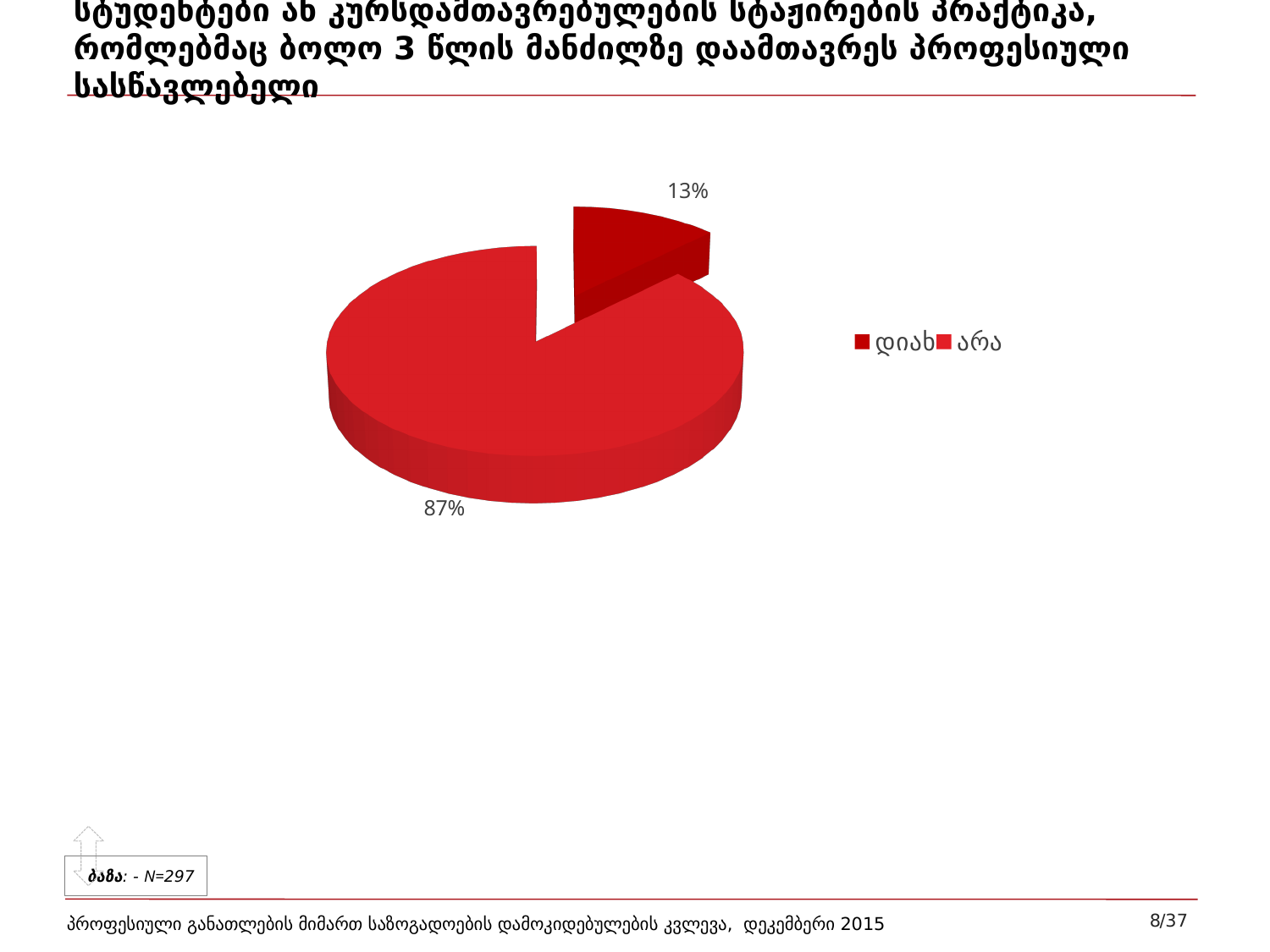
What are the two entries listed in the chart legend? დიახ and არა Which slice is larger, "დიახ" or "არა"? არა What percentage of the pie chart is labelled for the slice "არა"? 87% Which category has the largest slice in the pie chart? არა How many slices does the pie chart have? 2 How many entries does the chart legend list? 2 What is the sample size (N) stated in the base note on the slide? N=297 What is the difference in percentage points between the "არა" slice and the "დიახ" slice? 74 percentage points What percentage of the pie chart is labelled for the slice "დიახ"? 13% What type of chart is shown on the slide? Pie chart Which category has the smallest slice in the pie chart? დიახ What share of the pie does the "დიახ" slice represent? 13%